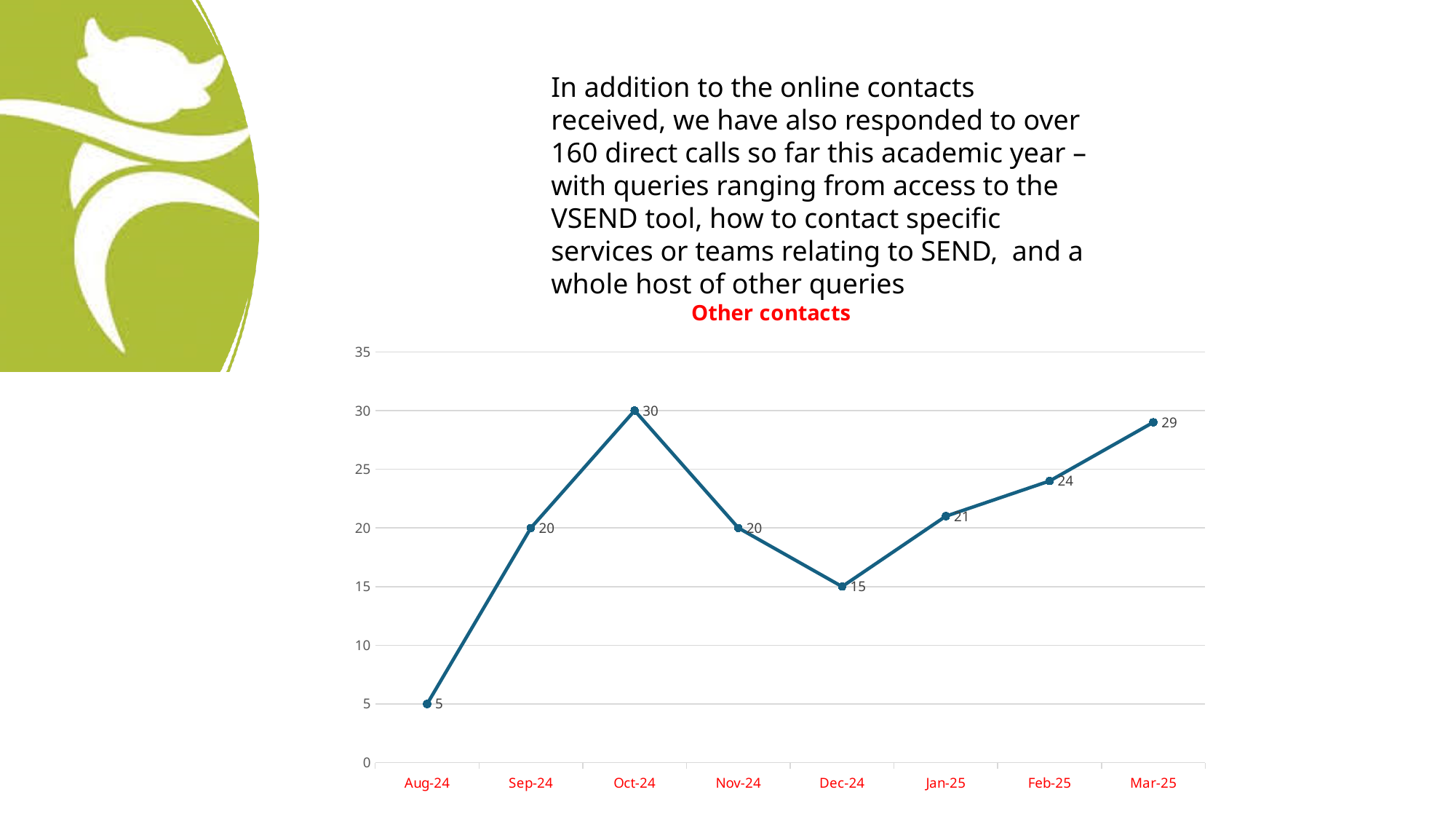
How many months are plotted on the chart? 8 What is the title of the chart? Other contacts Which month has the lowest value? Aug-24 What is the difference between the values for Oct-24 and Dec-24? 15 What is the value for Oct-24? 30 What kind of chart is shown? line chart Is the value for Mar-25 greater or less than 25? greater What is the value for Feb-25? 24 Do the values rise or fall from Dec-24 to Mar-25? rise Which is larger, the value for Jan-25 or the value for Nov-24? Jan-25 What is the value for Aug-24? 5 Which month has the highest value? Oct-24